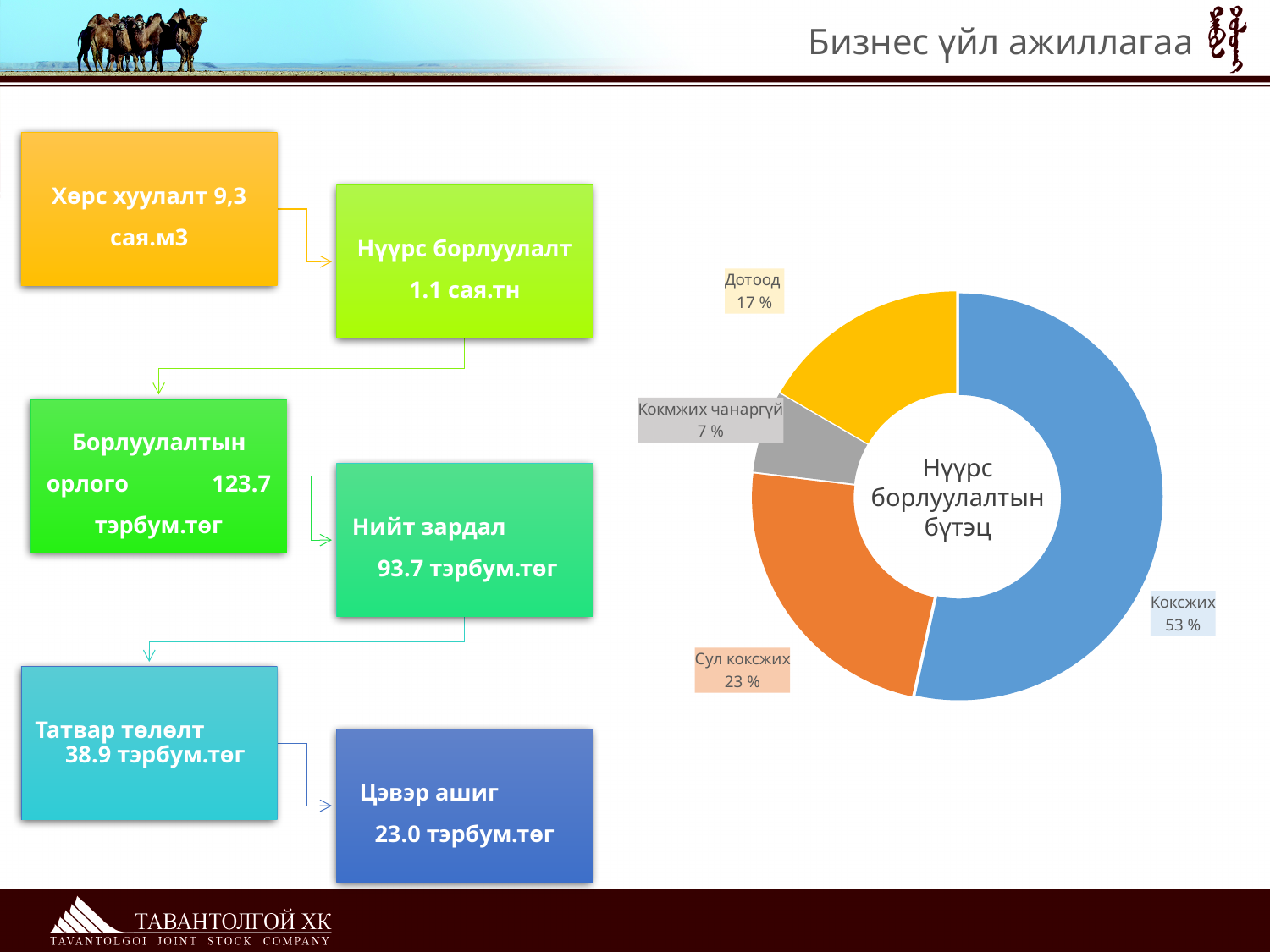
Which slice of the doughnut chart is the smallest? Кокмжих чанаргүй What share does Коксжих have in the doughnut chart? 53 % What share does Дотоод have in the doughnut chart? 17 % What is the difference in percentage points between Коксжих and Сул коксжих? 30 What share does Кокмжих чанаргүй have in the doughnut chart? 7 % What is the title shown in the centre of the doughnut chart? Нүүрс борлуулалтын бүтэц How many slices does the doughnut chart have? 4 What share does Сул коксжих have in the doughnut chart? 23 % What colour is the Коксжих slice in the doughnut chart? Blue What kind of chart is shown on the slide? Doughnut chart Which slice of the doughnut chart is the largest? Коксжих Which is larger in the doughnut chart, Дотоод or Сул коксжих? Сул коксжих